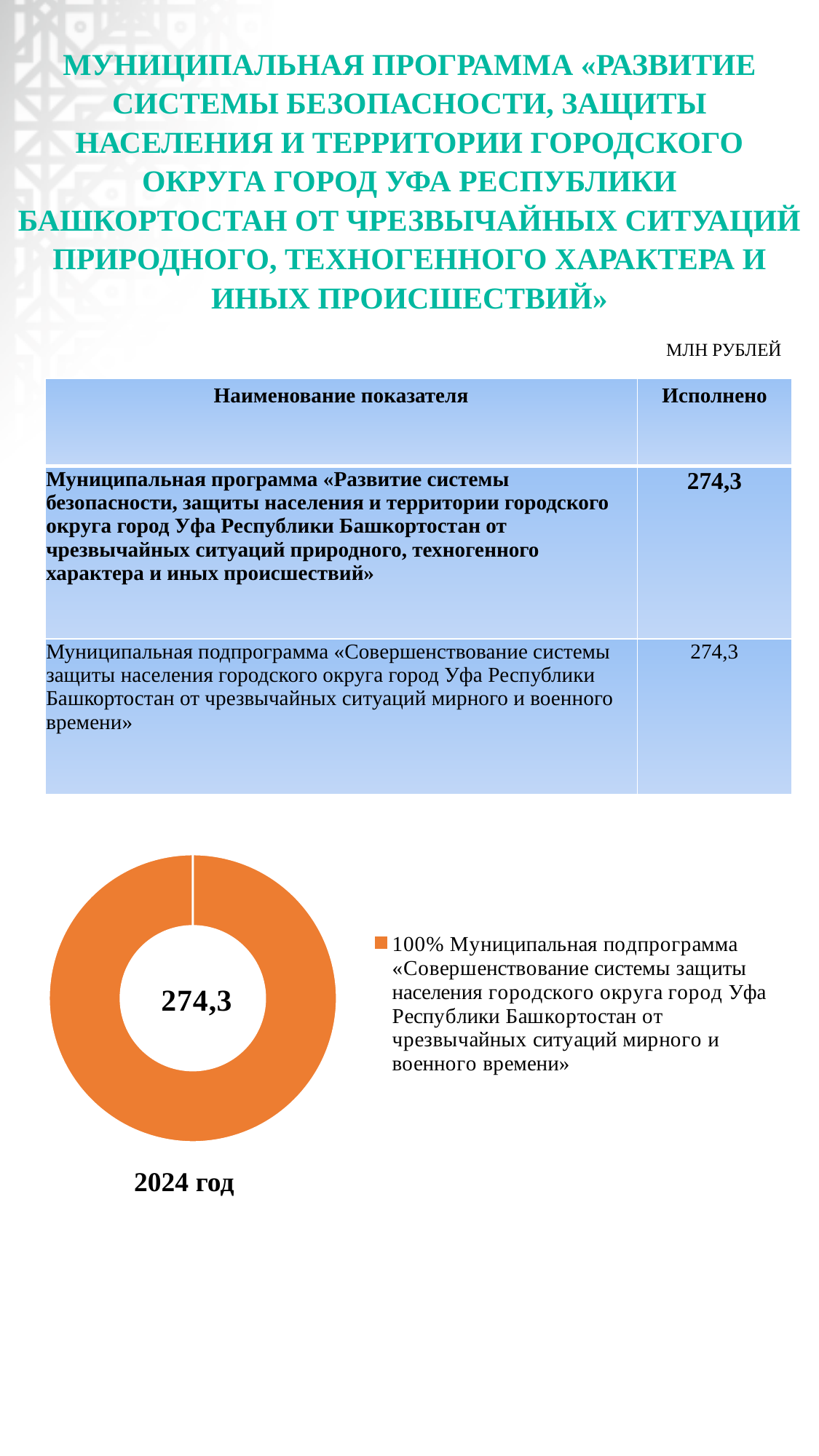
What kind of chart is shown on the slide? doughnut (pie) chart What colour is the single slice of the doughnut chart? orange What value is printed in the centre of the doughnut chart? 274,3 How many entries does the legend of the doughnut chart list? 1 What share of the doughnut chart does the slice for «Муниципальная подпрограмма «Совершенствование системы защиты населения городского округа город Уфа Республики Башкортостан от чрезвычайных ситуаций мирного и военного времени»» represent? 100% What year is labelled beneath the doughnut chart? 2024 год Is the value shown in the centre of the doughnut chart greater or less than 200? greater How many slices does the doughnut chart have? 1